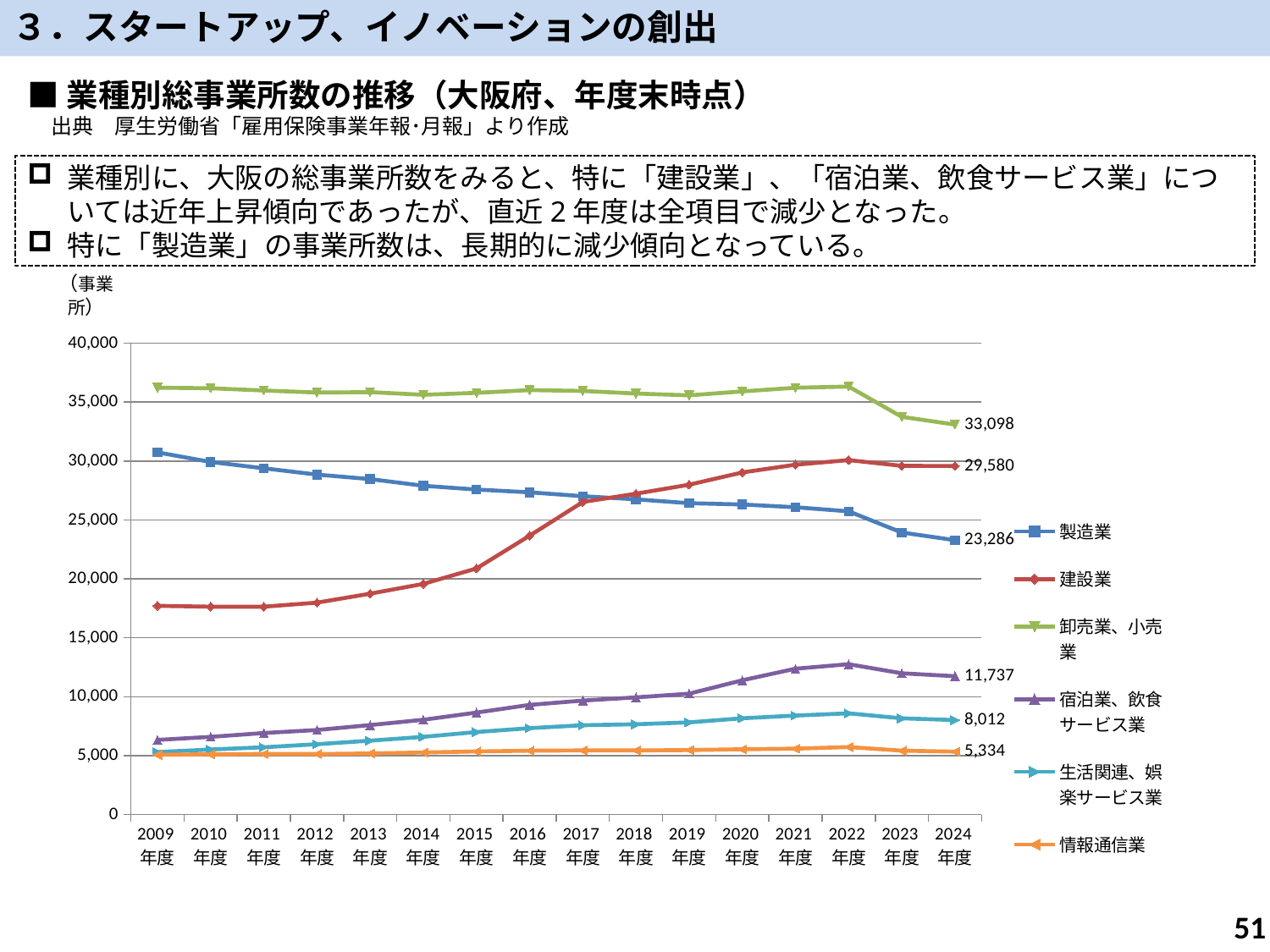
Is the value for 建設業 in 2009年度 greater or less than 20,000? less What is the value for 建設業 in 2024年度? 29,580 What is the value for 情報通信業 in 2024年度? 5,334 Which series has the highest value in 2024年度? 卸売業、小売業 What kind of chart is shown on the slide? line chart What is the value for 卸売業、小売業 in 2024年度? 33,098 How many series does the legend list? 6 Which series has the lowest value in 2024年度? 情報通信業 What is the difference between 建設業 and 製造業 in 2024年度? 6,294 What is the value for 宿泊業、飲食サービス業 in 2024年度? 11,737 What is the value for 製造業 in 2024年度? 23,286 Does the value for 製造業 rise or fall from 2009年度 to 2024年度? fall